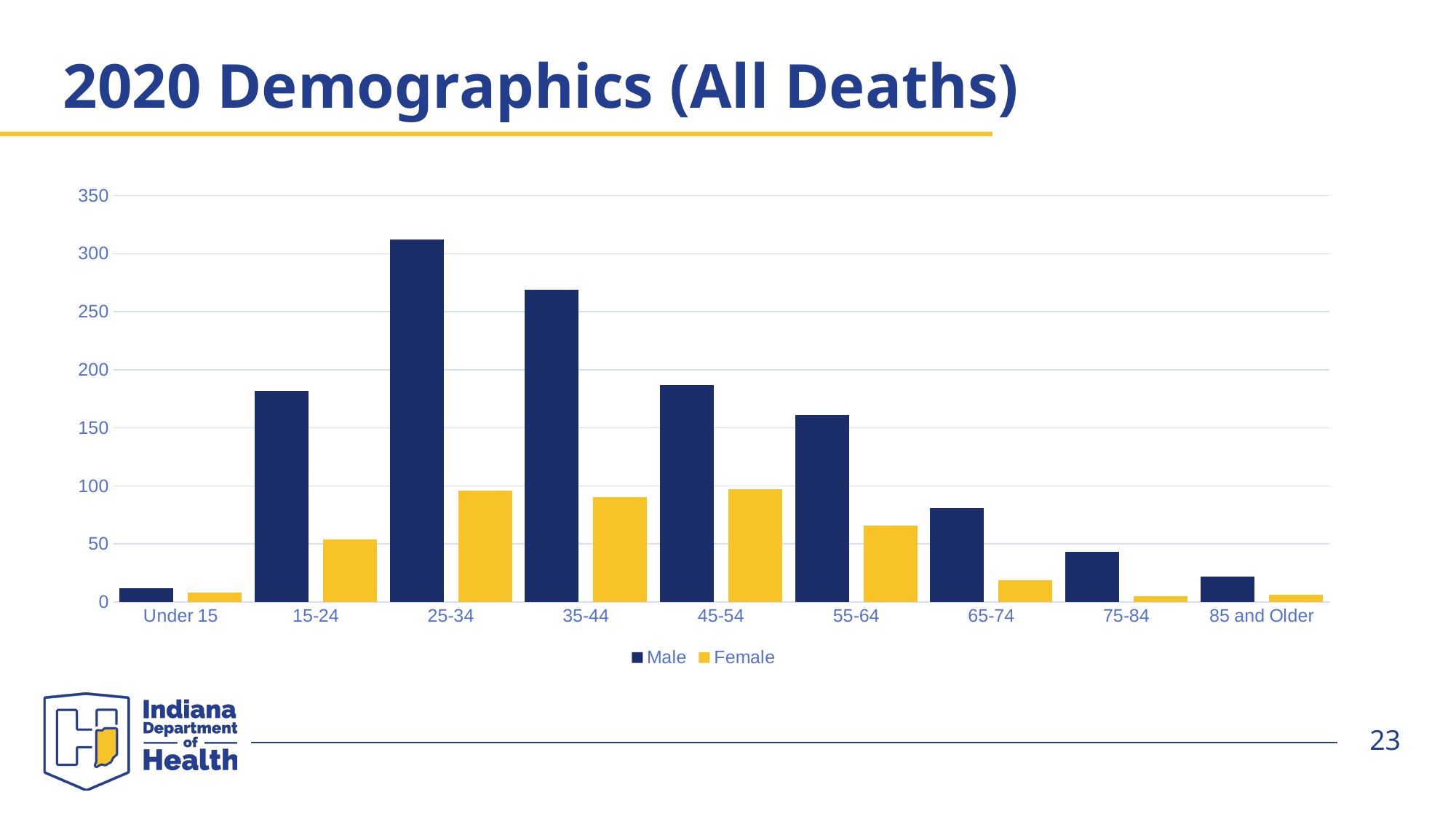
In the 25-34 age group, which series has the larger value, Male or Female? Male Is the Male value for 15-24 greater or less than 150? greater Is the Male value for 65-74 greater or less than 100? less Which age group has the highest Male value? 25-34 Which is larger, the Male value for 35-44 or the Male value for 45-54? 35-44 Which age group has the lowest Male value? Under 15 Do the Male values rise or fall from 25-34 through 85 and Older? fall What kind of chart is shown on the slide? bar chart How many series does the legend list? 2 Is the Male value for 25-34 greater or less than 300? greater How many age categories are shown on the x axis? 9